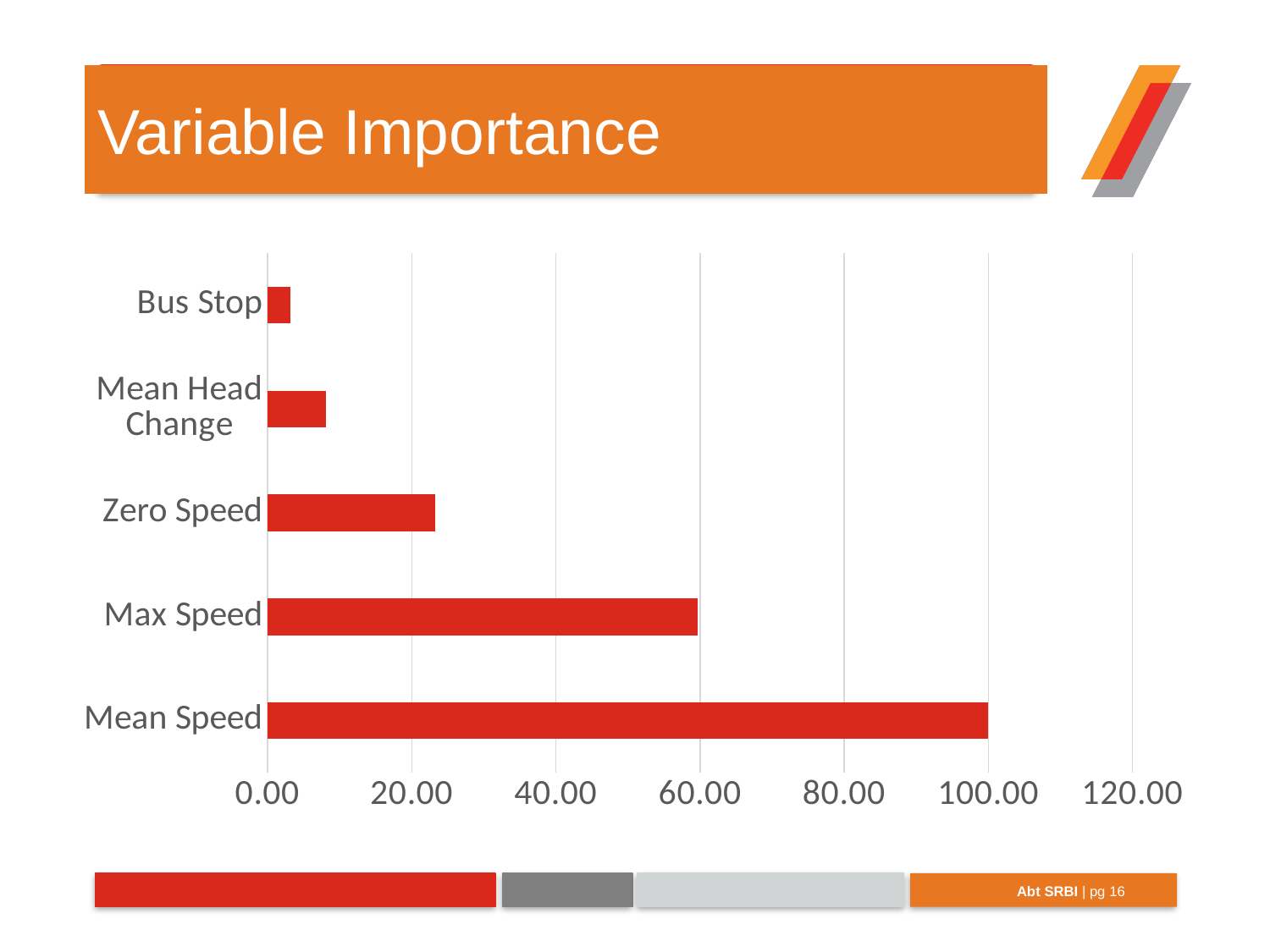
How many categories are plotted in the chart? 5 Which category has the highest value in the chart? Mean Speed Is the value for Zero Speed greater or less than 40.00? less Is the value for Bus Stop greater or less than 20.00? less What is the value for Mean Speed? 100.00 Is the value for Mean Head Change greater or less than 20.00? less Which is larger, the value for Max Speed or the value for Zero Speed? Max Speed What is the title of the slide containing the chart? Variable Importance Which is larger, the value for Zero Speed or the value for Mean Head Change? Zero Speed Which category has the lowest value in the chart? Bus Stop What kind of chart is shown on the slide? bar chart